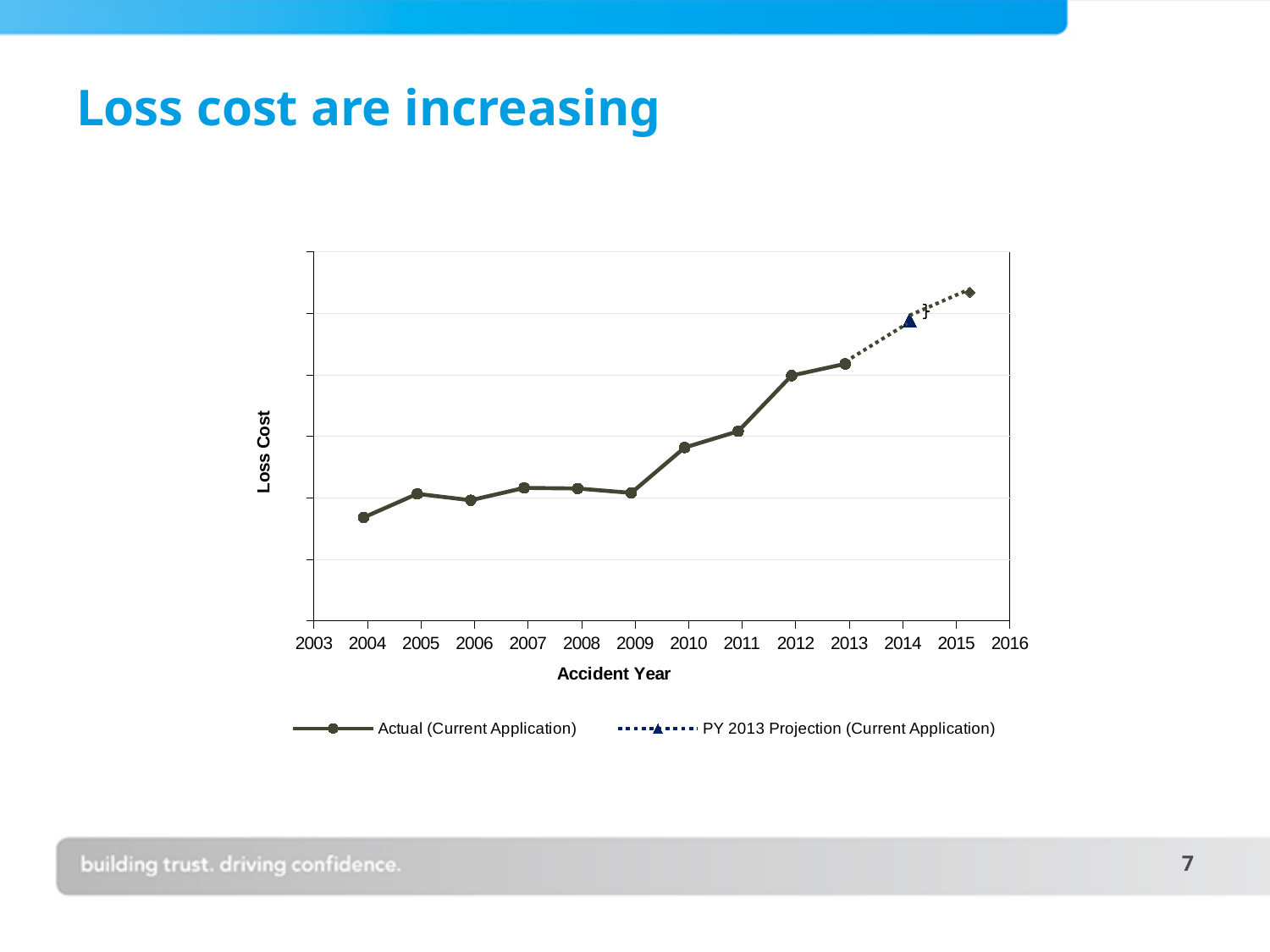
Is the Actual loss cost larger in 2012 or in 2009? 2012 Does the Actual (Current Application) loss cost rise or fall from 2009 to 2013? Rise What is the label of the x axis? Accident Year Is the Actual loss cost larger in 2010 or in 2004? 2010 How many data points does the Actual (Current Application) series have? 10 How many series does the legend list? 2 What kind of chart is shown on the slide? Line chart In which accident year is the Actual (Current Application) loss cost lowest? 2004 Which accident year is the first point of the Actual (Current Application) series? 2004 What is the title of the slide? Loss cost are increasing In which accident year is the Actual (Current Application) loss cost highest? 2013